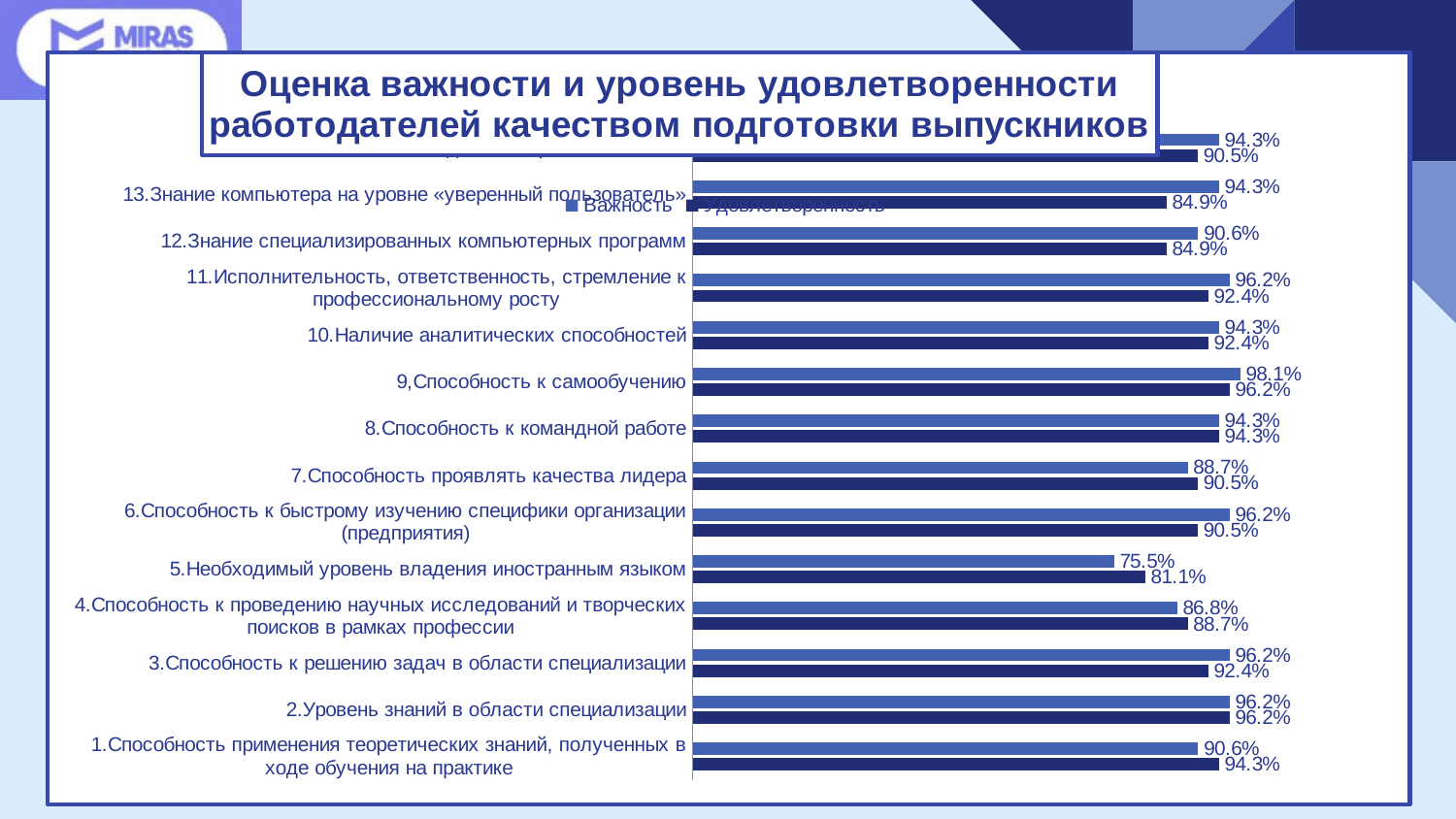
What is the title of the chart? Оценка важности и уровень удовлетворенности работодателей качеством подготовки выпускников Which category has the highest Важность value? 9.Способность к самообучению What is the Удовлетворенность value for "5.Необходимый уровень владения иностранным языком"? 81.1% For "7.Способность проявлять качества лидера", which is larger: Важность or Удовлетворенность? Удовлетворенность For "12.Знание специализированных компьютерных программ", which is larger: Важность or Удовлетворенность? Важность Which category has the lowest Важность value? 5.Необходимый уровень владения иностранным языком What is the Важность value for "9.Способность к самообучению"? 98.1% How many series does the chart's legend list? 2 What is the Важность value for "13.Знание компьютера на уровне «уверенный пользователь»"? 94.3% What type of chart is shown on the slide? bar chart What is the Удовлетворенность value for "1.Способность применения теоретических знаний, полученных в ходе обучения на практике"? 94.3% What is the difference between the Важность and Удовлетворенность values for "13.Знание компьютера на уровне «уверенный пользователь»"? 9.4%